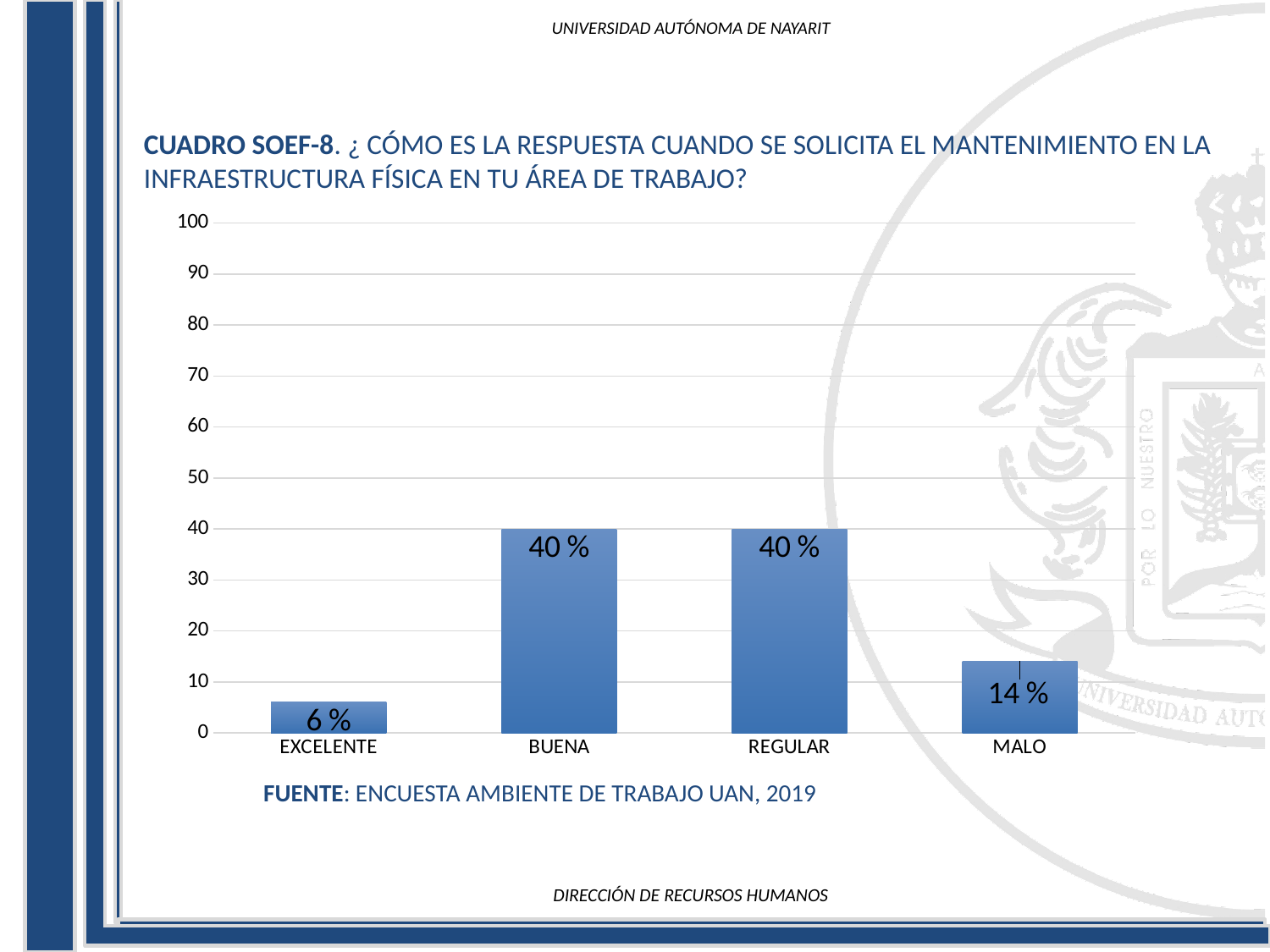
What kind of chart is shown on the slide? bar chart What is the value for EXCELENTE? 6 % Which is larger, the value for REGULAR or the value for MALO? REGULAR What is the source cited below the chart? ENCUESTA AMBIENTE DE TRABAJO UAN, 2019 What is the difference between the values for BUENA and MALO? 26 % How many categories are shown on the x axis? 4 What is the value for BUENA? 40 % What is the difference between the values for MALO and EXCELENTE? 8 % What is the highest value shown on the y axis? 100 Which category has the lowest value? EXCELENTE Is the value for MALO greater or less than 20? less What is the value for MALO? 14 %